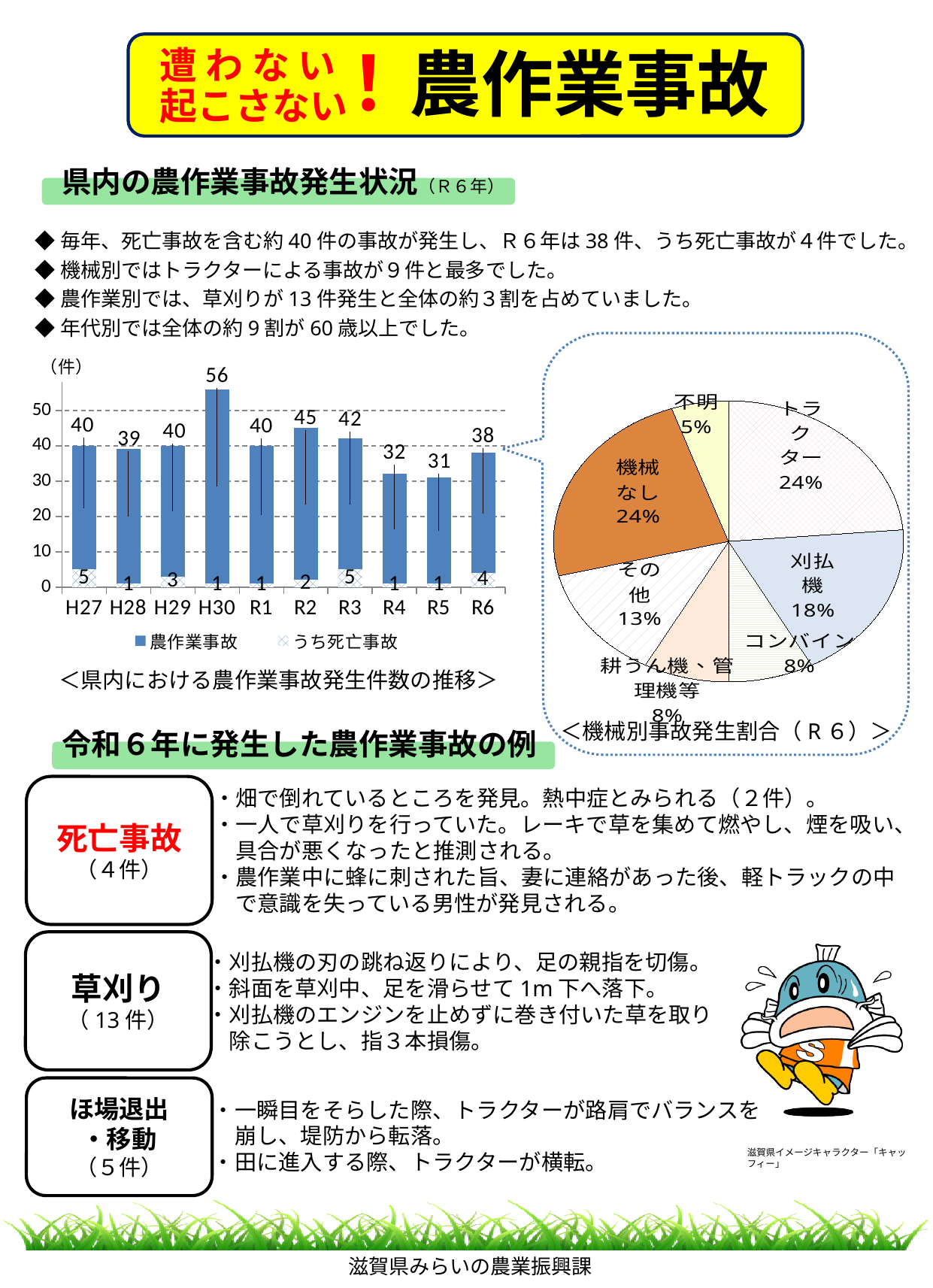
In the pie chart titled 機械別事故発生割合（R6）, which category has the smallest share? 不明 What kind of chart is the chart titled 機械別事故発生割合（R6）? pie chart In the bar chart titled 県内における農作業事故発生件数の推移, how many series does the legend list? 2 In the bar chart titled 県内における農作業事故発生件数の推移, what is the value of 農作業事故 for H30? 56 In the bar chart titled 県内における農作業事故発生件数の推移, what is the value of うち死亡事故 for R6? 4 In the pie chart titled 機械別事故発生割合（R6）, how many categories are shown? 7 In the bar chart titled 県内における農作業事故発生件数の推移, which is larger, the 農作業事故 value for R2 or for R3? R2 In the pie chart titled 機械別事故発生割合（R6）, what share does 刈払機 have? 18% In the bar chart titled 県内における農作業事故発生件数の推移, how many years are shown on the x axis? 10 In the bar chart titled 県内における農作業事故発生件数の推移, which year has the lowest number of 農作業事故? R5 In the bar chart titled 県内における農作業事故発生件数の推移, which year has the highest number of 農作業事故? H30 In the bar chart titled 県内における農作業事故発生件数の推移, what is the difference between the 農作業事故 values for H30 and R6? 18